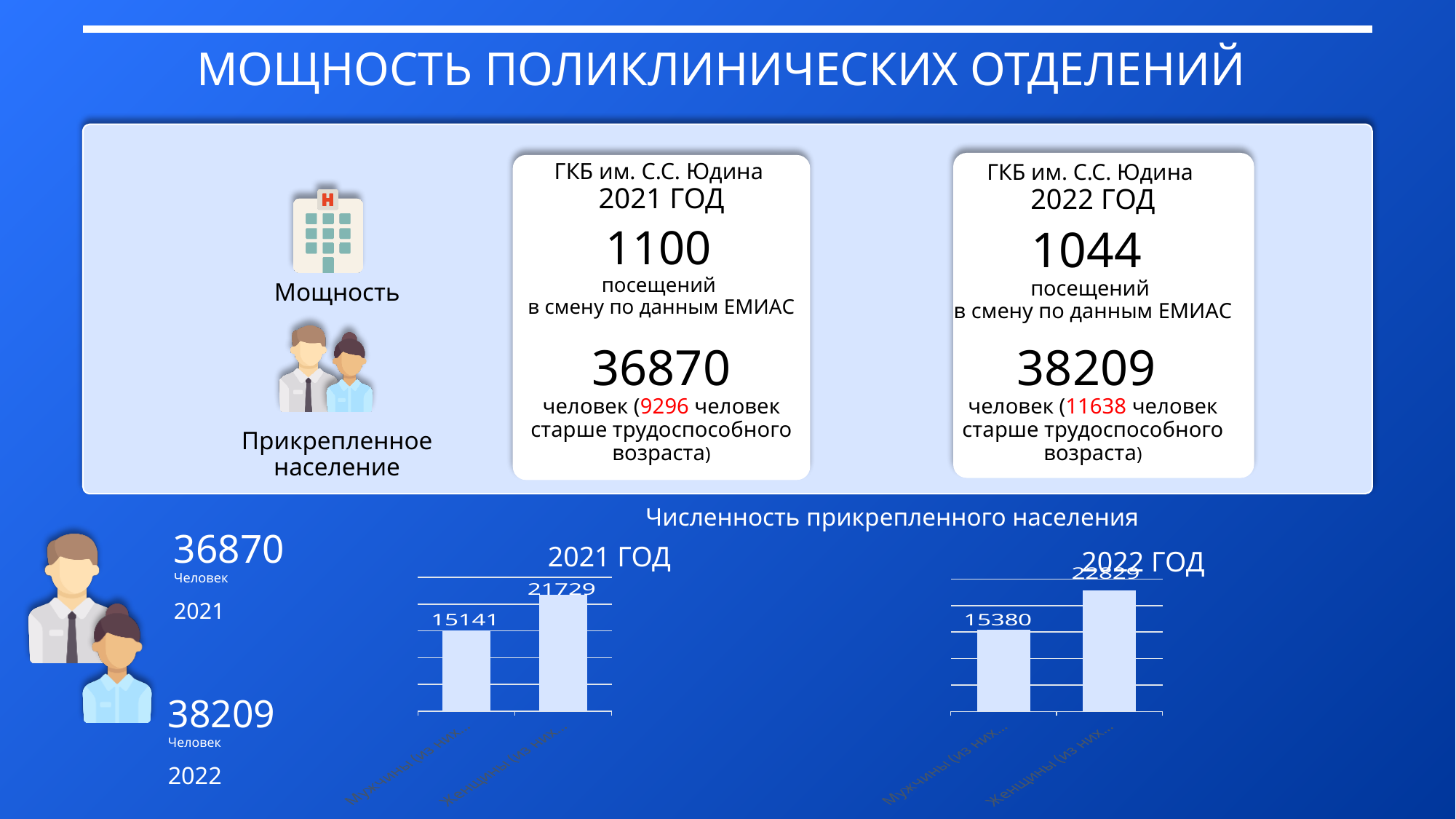
In the "2021 ГОД" chart, what is the value for Женщины? 21729 What kind of chart is the "2021 ГОД" chart? bar chart In the "2022 ГОД" chart, what is the difference between the values for Женщины and Мужчины? 7449 In the "2022 ГОД" chart, what is the value for Мужчины? 15380 In the "2021 ГОД" chart, which category has the highest value? Женщины In the "2022 ГОД" chart, what is the value for Женщины? 22829 How many categories are shown in the "2021 ГОД" chart? 2 In the "2021 ГОД" chart, what is the difference between the values for Женщины and Мужчины? 6588 Is the value for Мужчины larger in the "2021 ГОД" chart or in the "2022 ГОД" chart? 2022 ГОД What is the common heading shown above the two bar charts? Численность прикрепленного населения In the "2022 ГОД" chart, which category has the lowest value? Мужчины In the "2021 ГОД" chart, what is the value for Мужчины? 15141